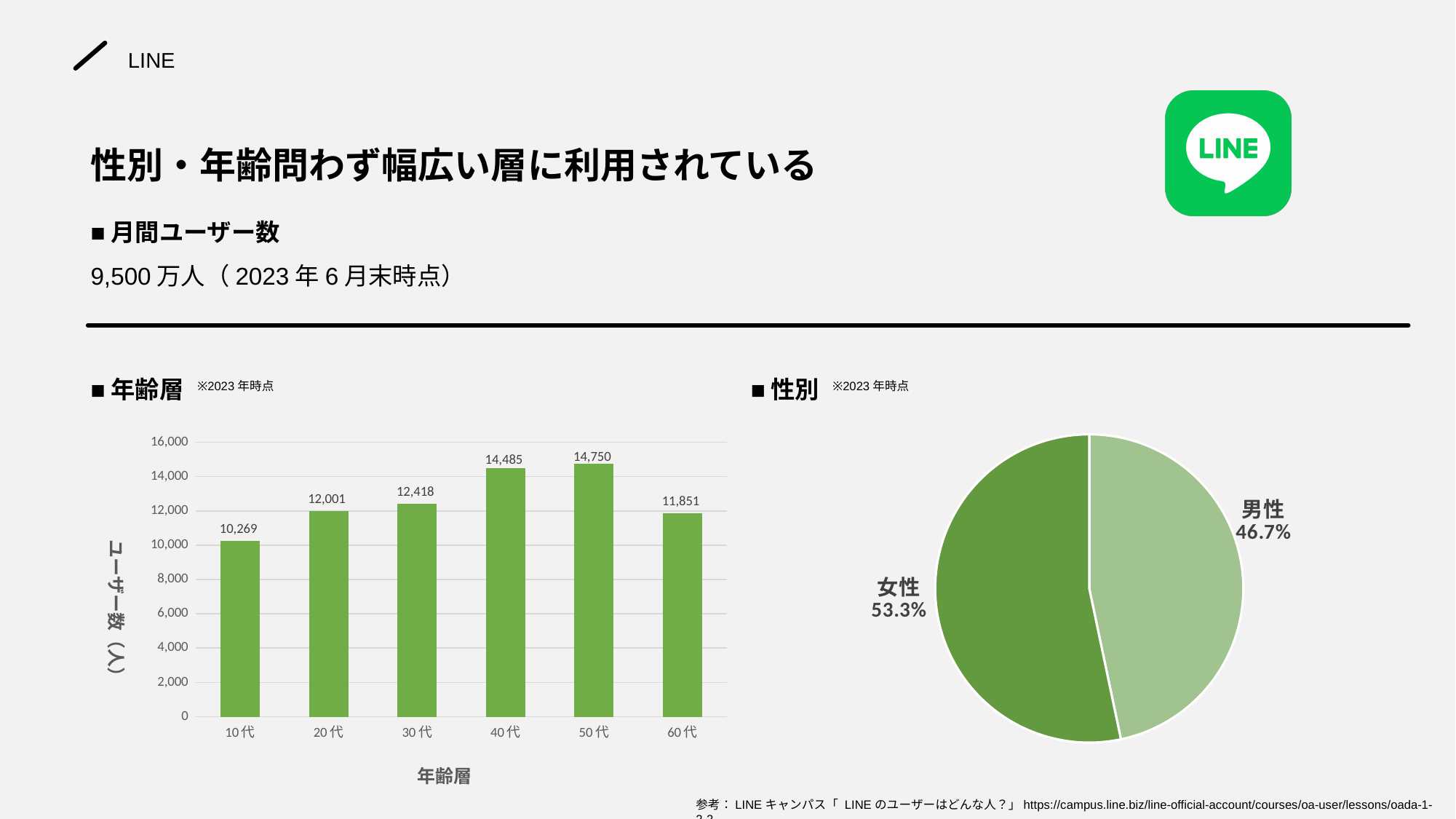
In the 年齢層 bar chart, which age group has the lowest value? 10代 In the 年齢層 bar chart, what is the value for 10代? 10,269 In the 年齢層 bar chart, what is the difference between the values for 50代 and 10代? 4,481 In the 年齢層 bar chart, which is larger, the value for 30代 or the value for 60代? 30代 In the 性別 pie chart, what share is 女性? 53.3% In the 年齢層 bar chart, how many age groups are shown? 6 In the 年齢層 bar chart, what is the value for 40代? 14,485 In the 年齢層 bar chart, which age group has the highest value? 50代 What kind of chart is the 年齢層 chart? bar chart What kind of chart is the 性別 chart? pie chart In the 性別 pie chart, what share is 男性? 46.7% In the 年齢層 bar chart, do the values rise or fall from 10代 to 50代? rise